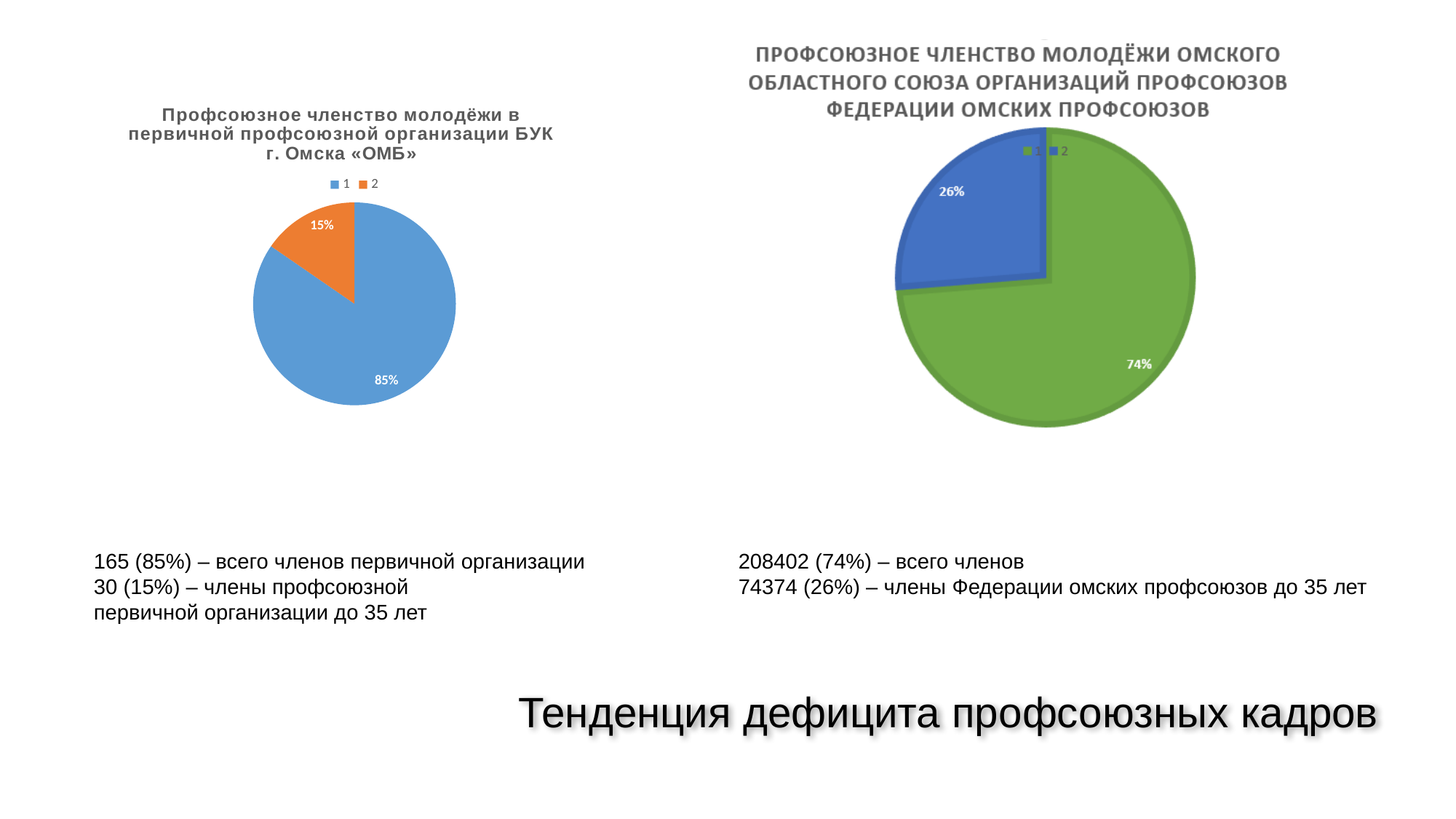
In the right pie chart, which slice is the smallest? 2 (26%) What type of chart is the right chart on the slide? pie chart In the left pie chart, what share does the blue slice (series 1) have? 85% What type of chart is the left chart on the slide? pie chart In the left pie chart, what is the difference between the two slices' shares? 70% In the right pie chart, what is the difference between the two slices' shares? 48% In the right pie chart, what share does the green slice (series 1) have? 74% In the left pie chart, which slice is the largest? 1 (85%) In the right pie chart, what share does the blue slice (series 2) have? 26% How many slices does the right pie chart have? 2 How many entries does the legend of the left pie chart list? 2